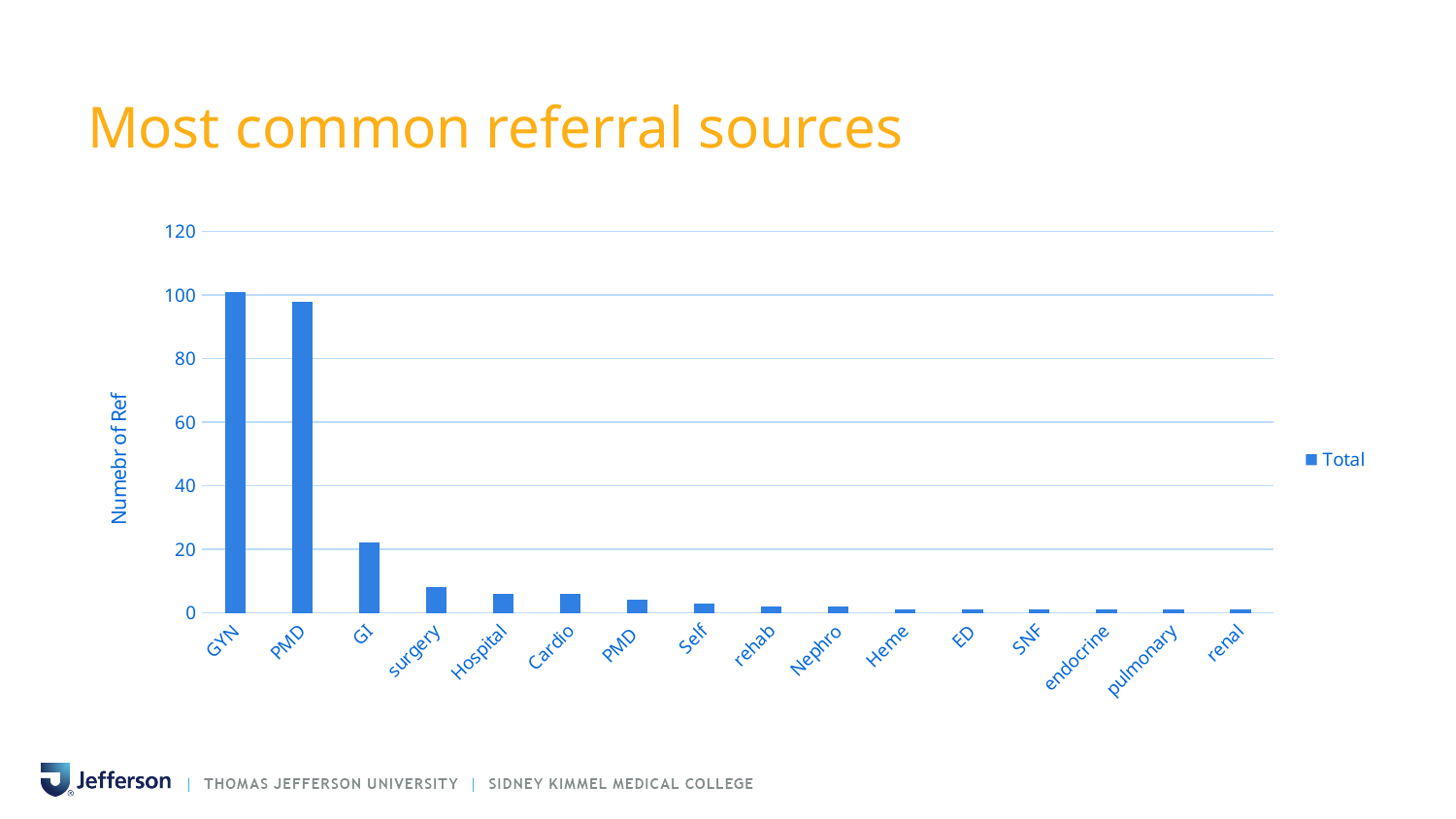
How many series does the legend list? 1 What is the title of the chart? Most common referral sources Is the value for surgery greater or less than 20? less Which has a larger value, GYN or GI? GYN What is the name of the series in the legend? Total What kind of chart is shown on the slide? bar chart Is the value for Hospital greater or less than 20? less Which has a larger value, GI or surgery? GI How many referral source categories are shown on the x axis? 16 Do the values generally rise or fall moving from left to right along the x axis? fall Is the value for GYN greater or less than 80? greater